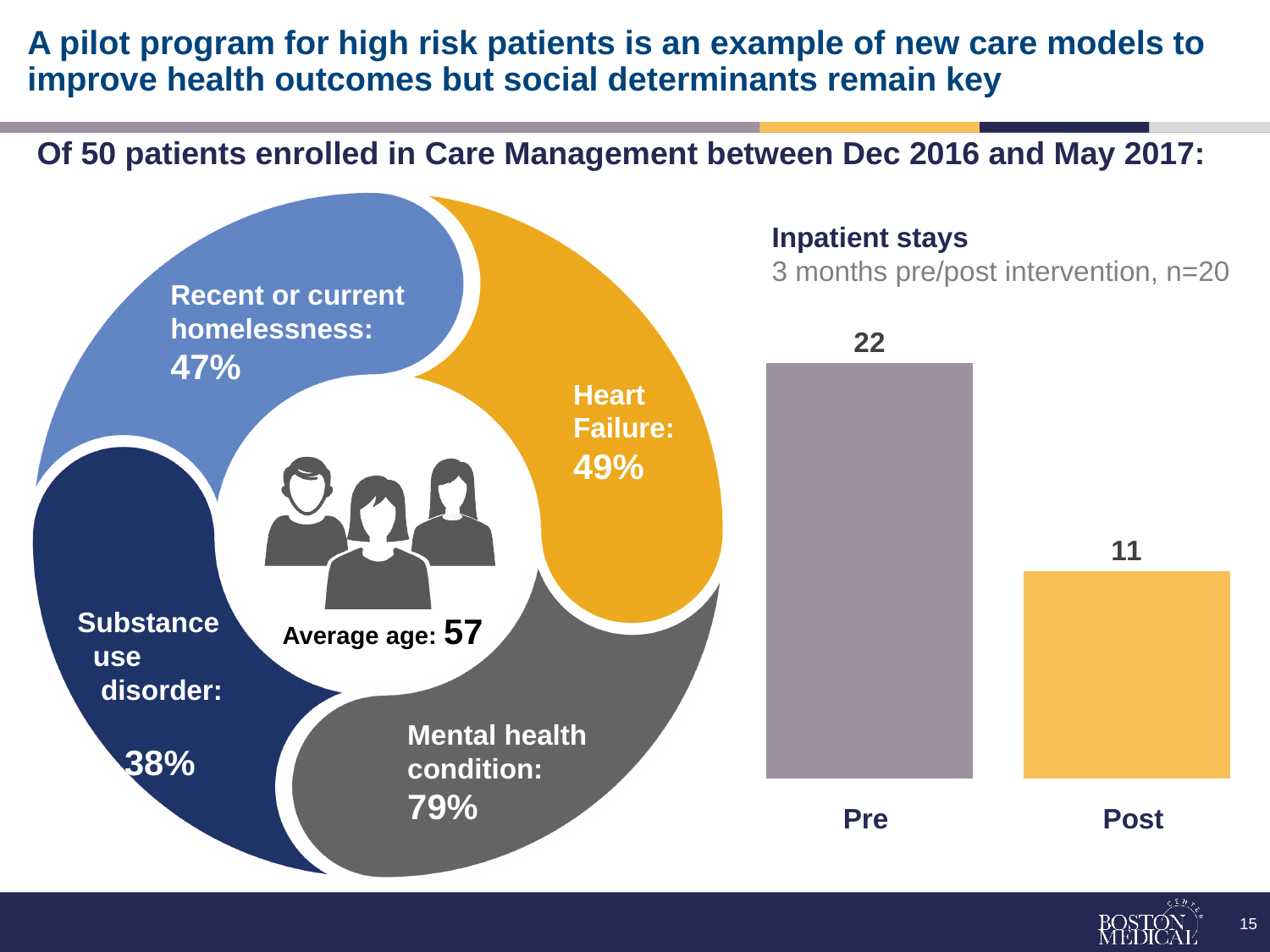
What kind of chart is the Inpatient stays chart? bar chart What is the subtitle under the Inpatient stays chart title? 3 months pre/post intervention, n=20 In the Inpatient stays chart, do the values rise or fall from Pre to Post? fall How many bars are shown in the Inpatient stays chart? 2 In the circular diagram on the left, what percentage of patients have a mental health condition? 79% In the Inpatient stays chart, is the Pre value larger or smaller than the Post value? larger In the Inpatient stays chart, what is the value for Pre? 22 In the Inpatient stays chart, what is the difference between the Pre and Post values? 11 In the circular diagram on the left, what percentage of patients have heart failure? 49% In the Inpatient stays chart, what is the value for Post? 11 In the Inpatient stays chart, which category has the lower value? Post In the Inpatient stays chart, which category has the higher value? Pre